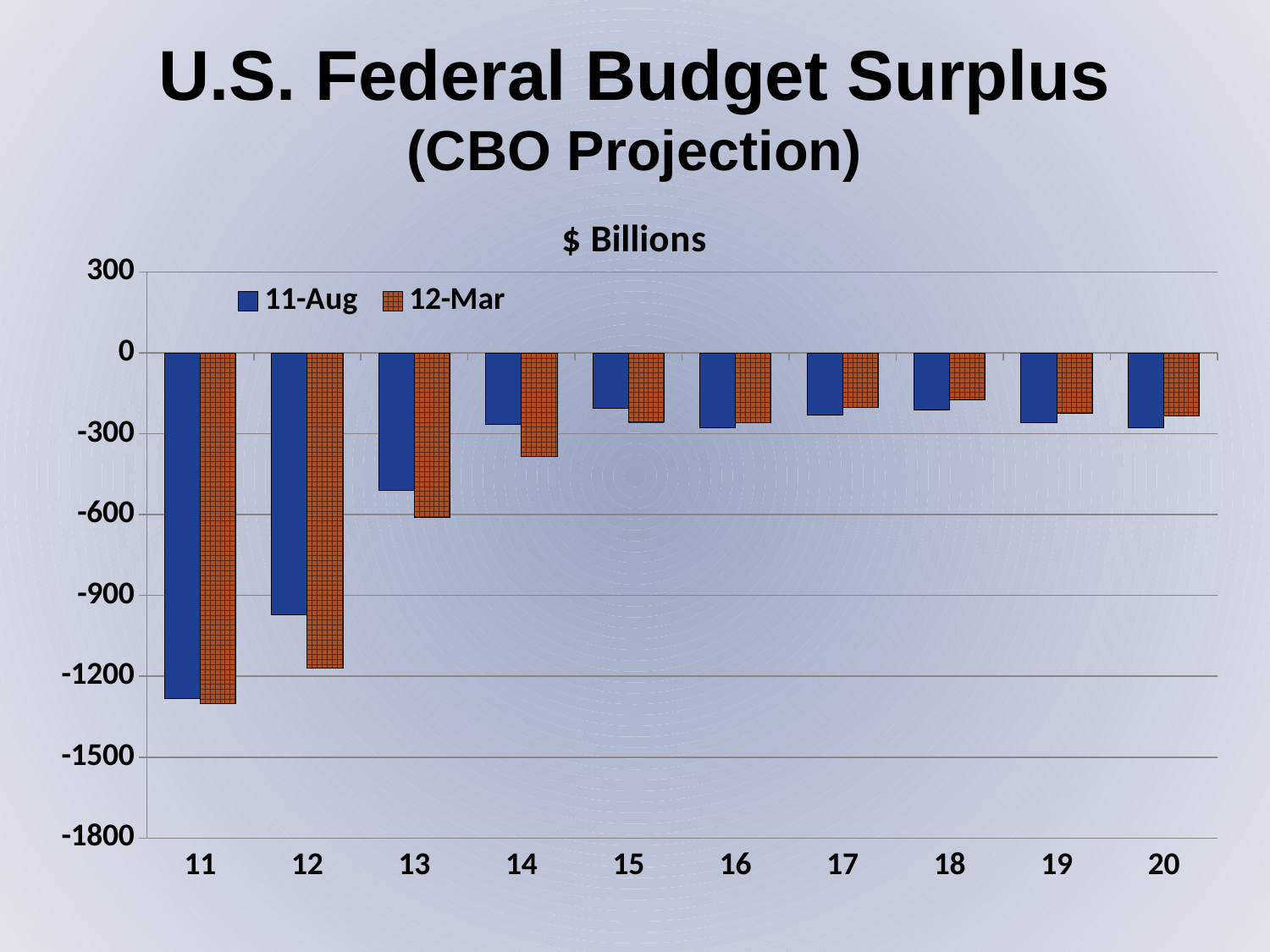
For year 12, which series has the larger (less negative) value, 11-Aug or 12-Mar? 11-Aug What kind of chart is shown on the slide? bar chart What are the two series named in the legend? 11-Aug and 12-Mar Is the 12-Mar value for year 14 greater or less than -300? less Which year has the lowest (most negative) 12-Mar value? 11 Is the 11-Aug value for year 12 greater or less than -900? less How many series does the legend list? 2 How many years are shown on the x axis of the chart? 10 What unit label appears above the chart? $ Billions Is the 11-Aug value for year 13 greater or less than -600? greater Do the 11-Aug values rise or fall from year 11 to year 15? rise